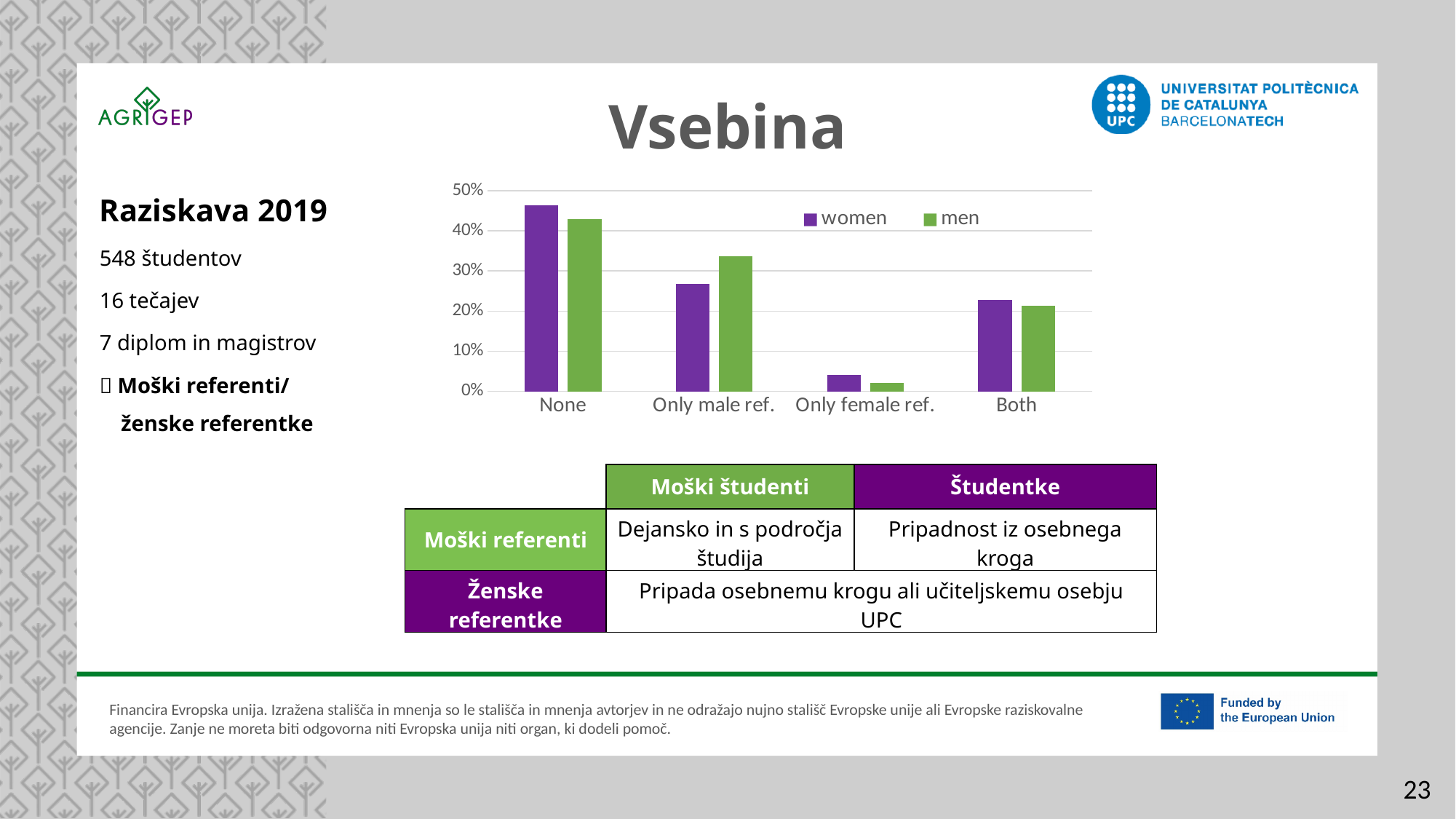
How many categories are shown on the x axis of the chart? 4 How many series does the chart legend list? 2 Is the value for men in the Only male ref. category greater or less than 30%? greater Is the value for women in the None category greater or less than 40%? greater What kind of chart is shown on the slide? bar chart For the category Only male ref., which series has the larger value, women or men? men For the category None, which series has the larger value, women or men? women Which category has the highest value for the women series? None Is the value for women in the Only female ref. category greater or less than 10%? less Which category has the lowest value for the men series? Only female ref. Which colour represents the men series in the chart? green